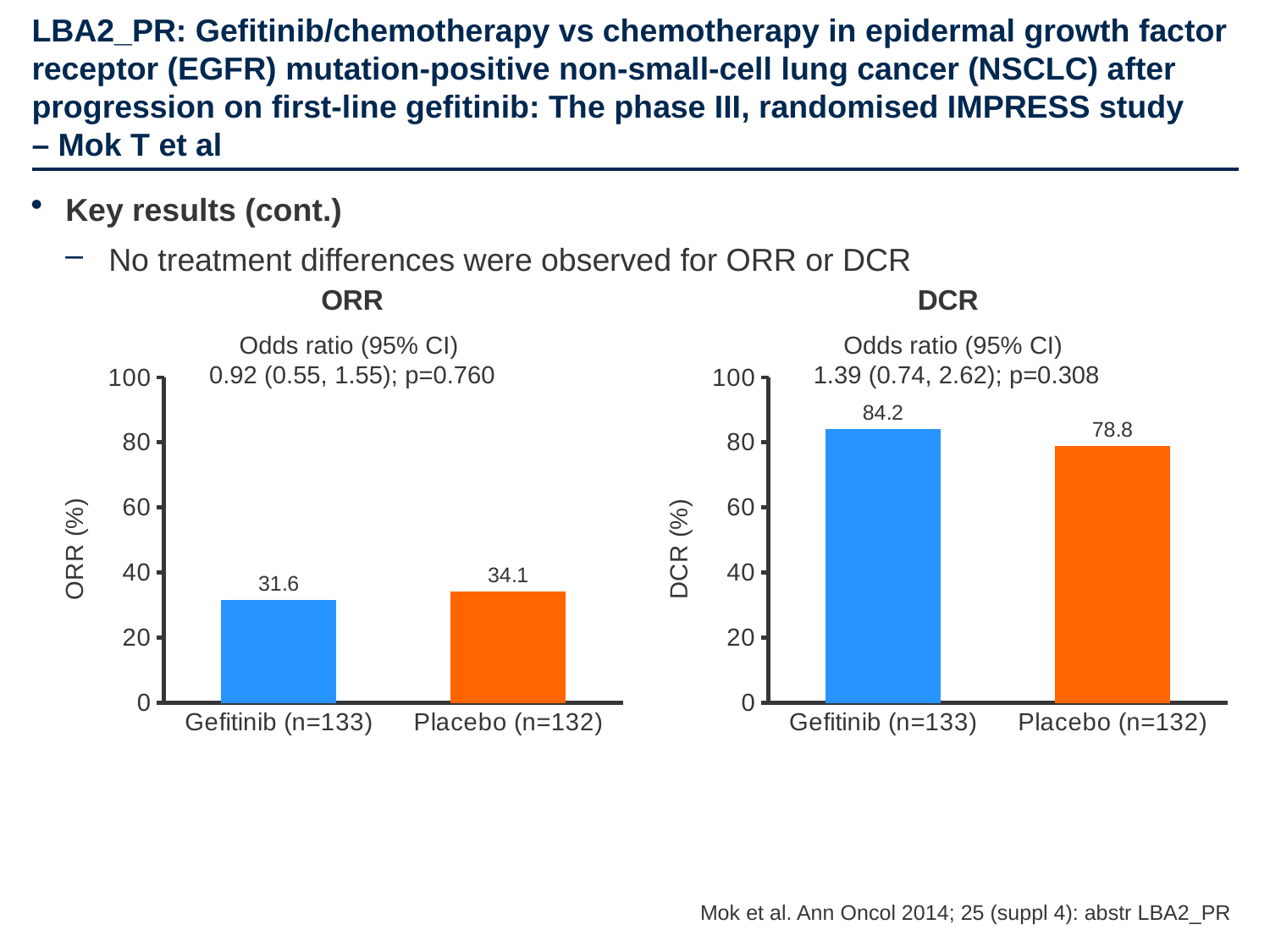
In the DCR chart, is the value for Gefitinib (n=133) greater or less than 80? greater In the DCR chart, what is the DCR (%) for Placebo (n=132)? 78.8 In the ORR chart, what is the difference in ORR (%) between Placebo (n=132) and Gefitinib (n=133)? 2.5 In the ORR chart, which group has the higher ORR? Placebo (n=132) In the ORR chart, what is the ORR (%) for Gefitinib (n=133)? 31.6 In the ORR chart, what odds ratio (95% CI) is shown above the bars? 0.92 (0.55, 1.55); p=0.760 In the DCR chart, which group has the lower DCR? Placebo (n=132) What type of chart is the DCR chart? Bar chart In the DCR chart, what is the difference in DCR (%) between Gefitinib (n=133) and Placebo (n=132)? 5.4 How many bars are shown in the ORR chart? 2 In the DCR chart, what is the DCR (%) for Gefitinib (n=133)? 84.2 In the ORR chart, what is the ORR (%) for Placebo (n=132)? 34.1